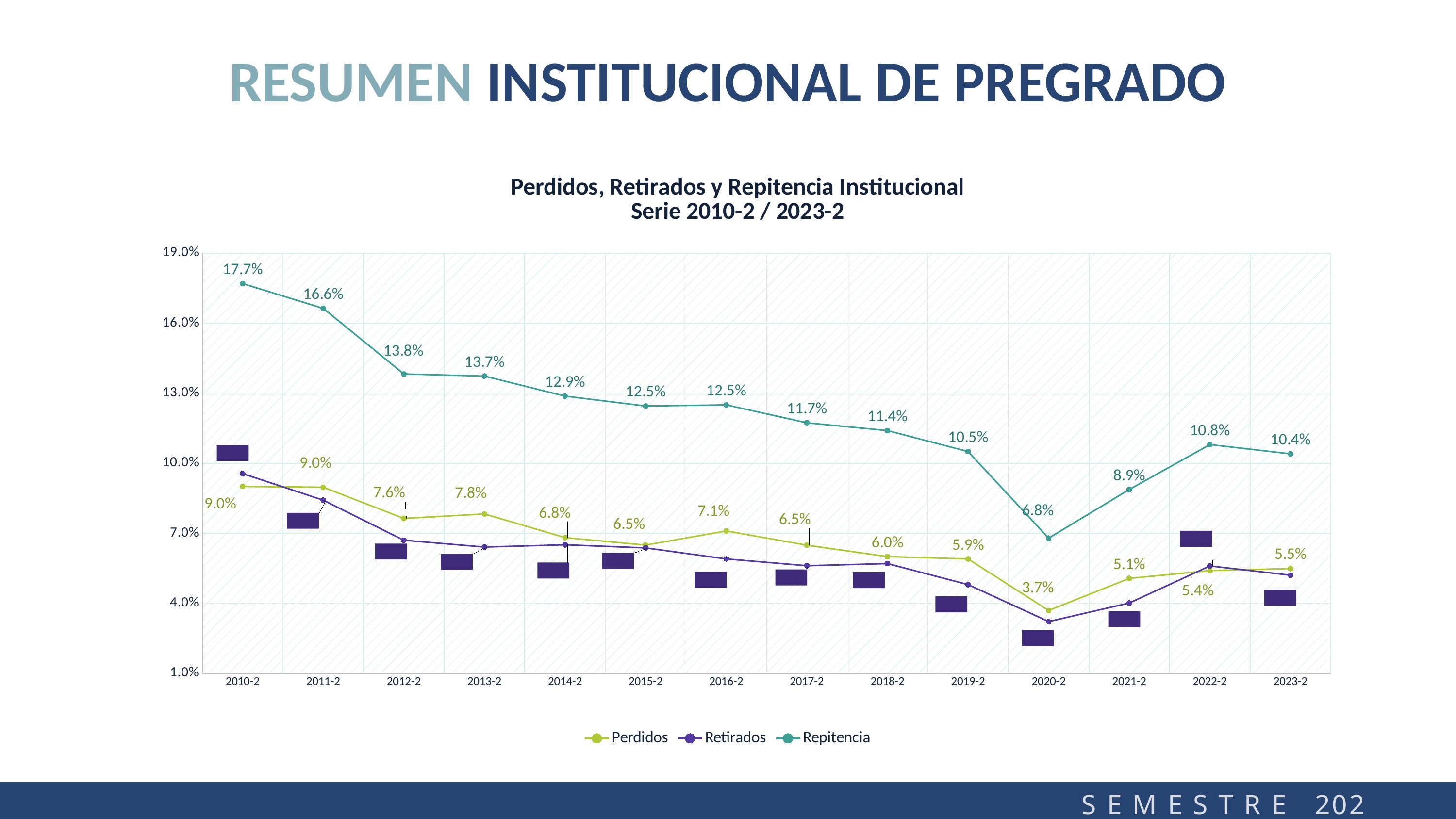
What is the title of the chart? Perdidos, Retirados y Repitencia Institucional Serie 2010-2 / 2023-2 Does the Repitencia series rise or fall from 2010-2 to 2019-2? fall What kind of chart is shown on the slide? line chart How many semesters are plotted on the x axis? 14 What is the Repitencia value for 2010-2? 17.7% In which semester is the Repitencia series highest? 2010-2 Is the Retirados value for 2020-2 greater or less than 4.0%? less How many series does the legend list? 3 Which semester has the higher Perdidos value, 2016-2 or 2017-2? 2016-2 What is the difference between the Repitencia values for 2010-2 and 2023-2? 7.3 percentage points What is the Perdidos value for 2020-2? 3.7% In which semester is the Repitencia series lowest? 2020-2